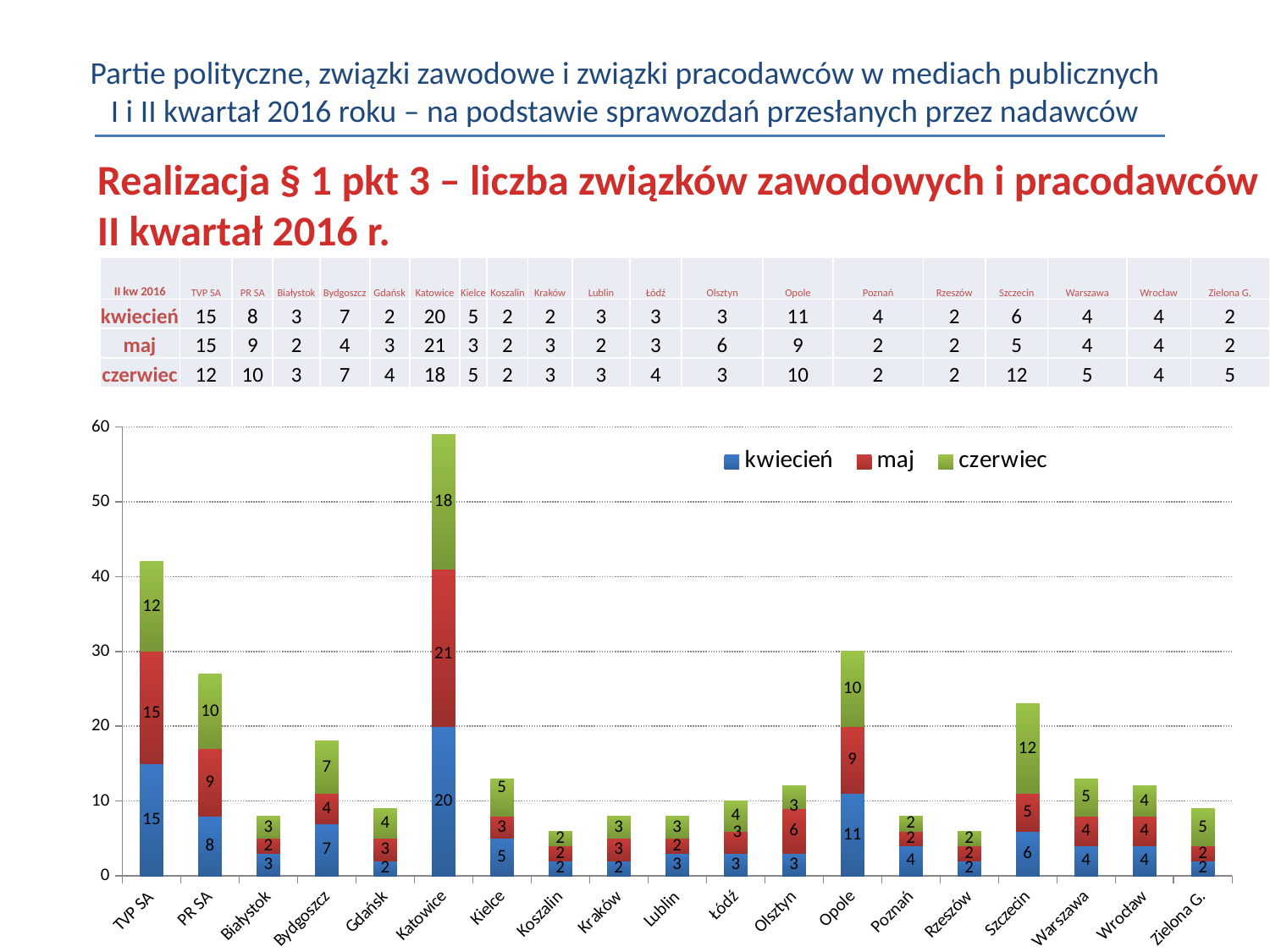
What is the difference between the maj value for Katowice and the maj value for TVP SA? 6 How many series does the chart legend list? 3 What kind of chart is shown on the slide? stacked bar chart Which category has the highest czerwiec value in the chart? Katowice How many categories are shown along the x axis of the chart? 19 Which is larger, the kwiecień value for Opole or the kwiecień value for PR SA? Opole What is the czerwiec value for Katowice in the chart? 18 What is the kwiecień value for Opole in the chart? 11 What is the total of the stacked bar for Szczecin? 23 What is the maj value for PR SA in the chart? 9 Which category has the tallest stacked bar in the chart? Katowice What is the total of the stacked bar for TVP SA? 42